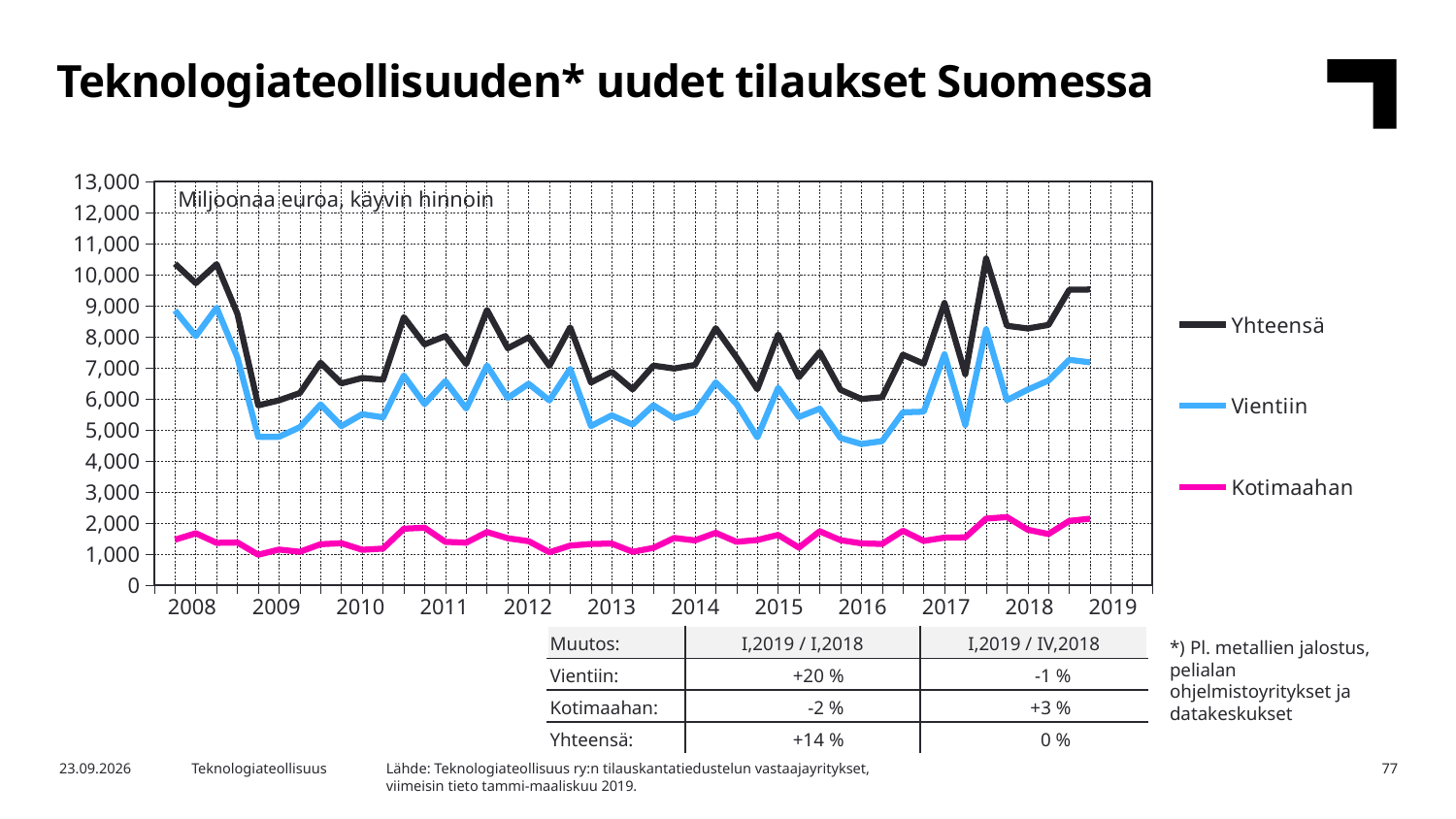
What unit is stated in the label inside the chart area? Miljoonaa euroa, käyvin hinnoin How many series does the legend list? 3 Which series has the lowest values throughout the chart? Kotimaahan Is the value for Yhteensä at the start of 2009 greater or less than 7,000? less Is the value for Vientiin in 2016 greater or less than 6,000? less Is the value for Kotimaahan in 2012 greater or less than 3,000? less What kind of chart is shown on the slide? line chart What are the three series named in the legend? Yhteensä, Vientiin, Kotimaahan How many year labels are shown on the x axis? 12 Which series is larger in 2015, Vientiin or Kotimaahan? Vientiin Which series has the highest values throughout the chart? Yhteensä